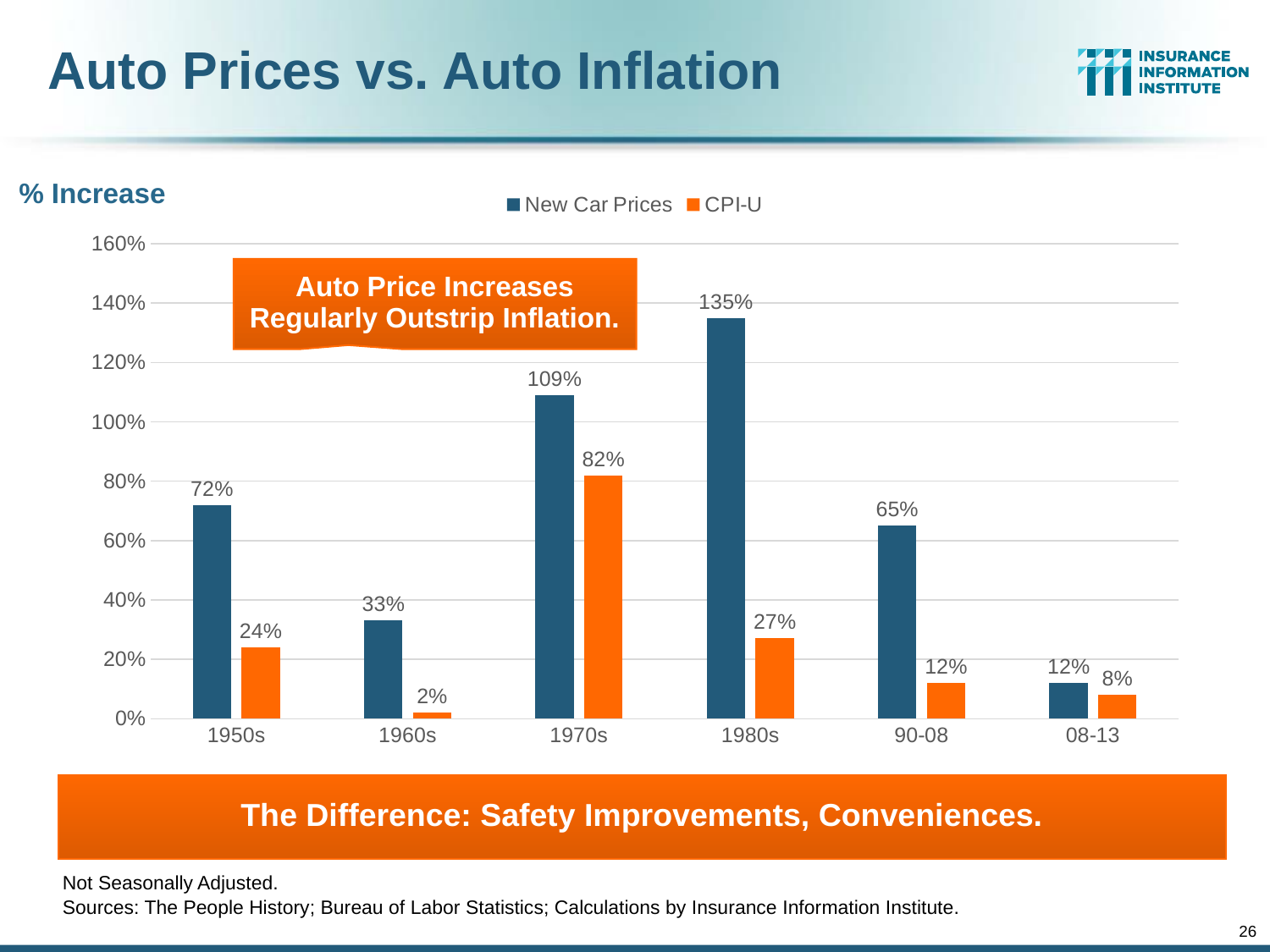
Which period has the lowest CPI-U value? 1960s Which series is shown in orange? CPI-U What is the CPI-U value for the 1980s? 27% Which period has the highest New Car Prices value? 1980s Which is larger in the 1950s, New Car Prices or CPI-U? New Car Prices What kind of chart is shown on the slide? Bar chart What is the New Car Prices value for the 1970s? 109% How many series does the legend list? 2 What is the difference between New Car Prices and CPI-U in the 1980s? 108% What is the CPI-U value for the 1960s? 2% What is the difference between the New Car Prices values for the 1970s and the 1950s? 37% How many periods are shown on the x axis? 6